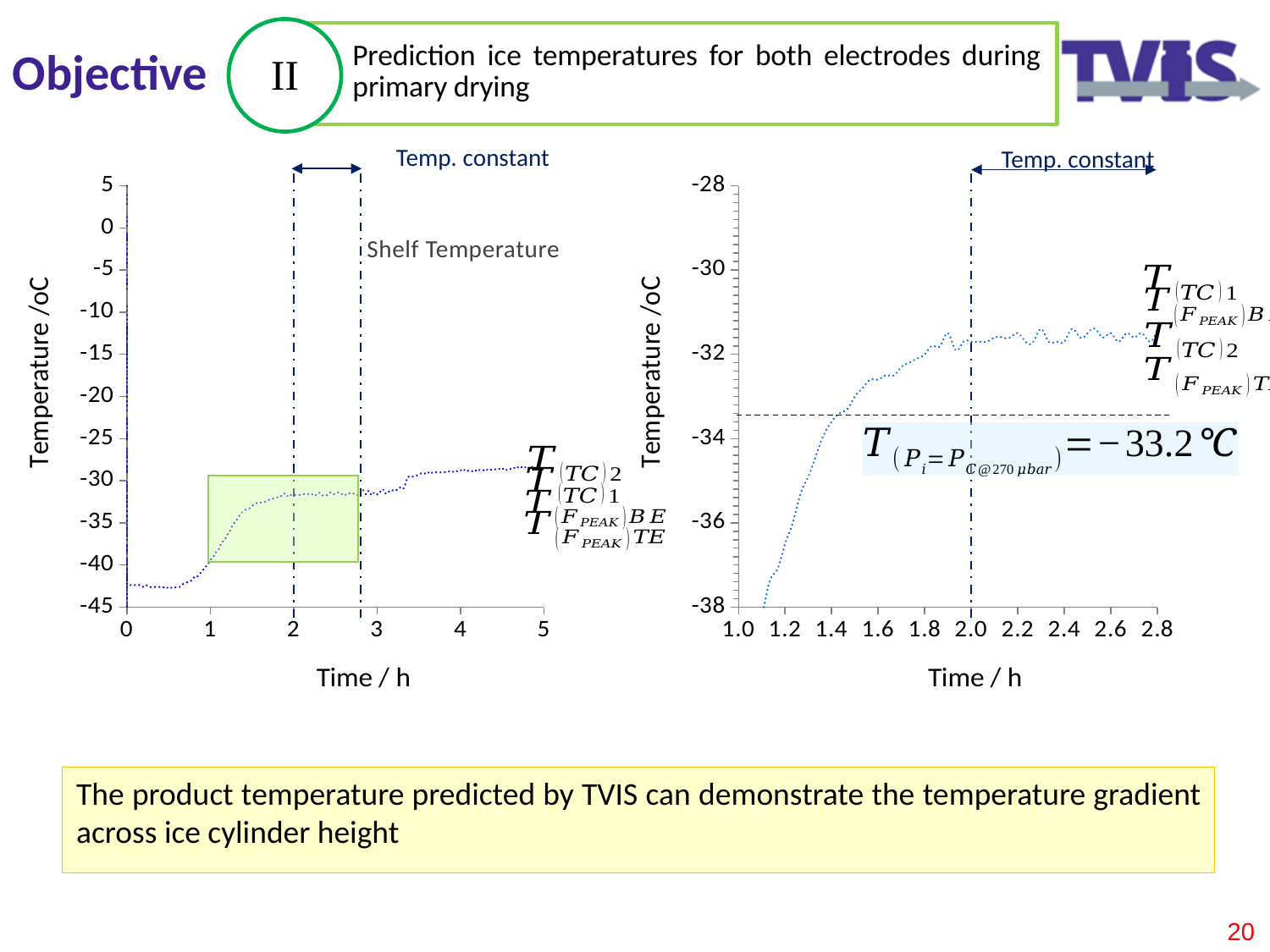
On the left chart, is the temperature at time 5 greater or less than -35? greater On the right chart, what is the lowest value shown on the y axis? -38 On the left chart, what is the label of the y axis? Temperature /oC On the left chart, does the dotted temperature line rise or fall between time 1 and time 2? rise On the left chart, what is the highest value shown on the y axis? 5 On the right chart, what temperature value is printed in the annotation T(Pi=Pc@270 µbar)? -33.2 °C On the left chart, what is the label of the x axis? Time / h What kind of chart is the left chart on the slide? line chart On the left chart, is the temperature at time 0 greater or less than -40? less On the right chart, does the dotted temperature line rise or fall between time 1.0 and time 2.0? rise On the right chart, is the temperature at time 1.2 greater or less than -34? less